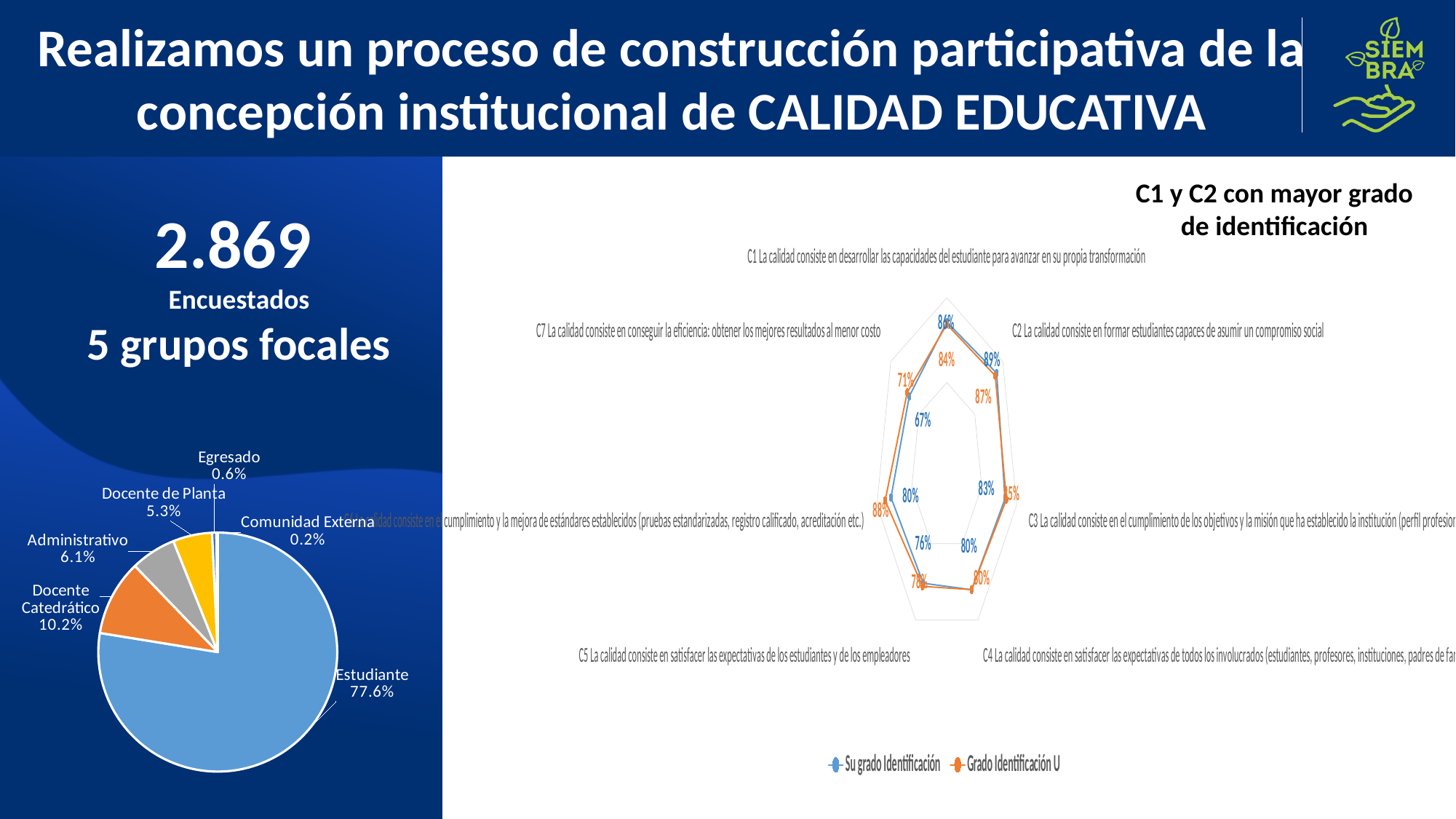
In the radar chart on the right, what is the value of 'Su grado Identificación' for C2? 89% What kind of chart is the chart on the right side of the slide? Radar chart In the pie chart on the left, what is the share for Docente Catedrático? 10.2% In the pie chart on the left, which is larger: Administrativo or Docente de Planta? Administrativo In the radar chart on the right, what is the value of 'Su grado Identificación' for C1? 86% What kind of chart is the chart on the left side of the slide? Pie chart In the pie chart on the left, which category has the smallest slice? Comunidad Externa How many series does the legend of the radar chart on the right list? 2 In the pie chart on the left, what is the difference between the Administrativo and Docente de Planta shares? 0.8% In the pie chart on the left, what is the share for Estudiante? 77.6% In the pie chart on the left, which category has the largest slice? Estudiante How many slices does the pie chart on the left have? 6